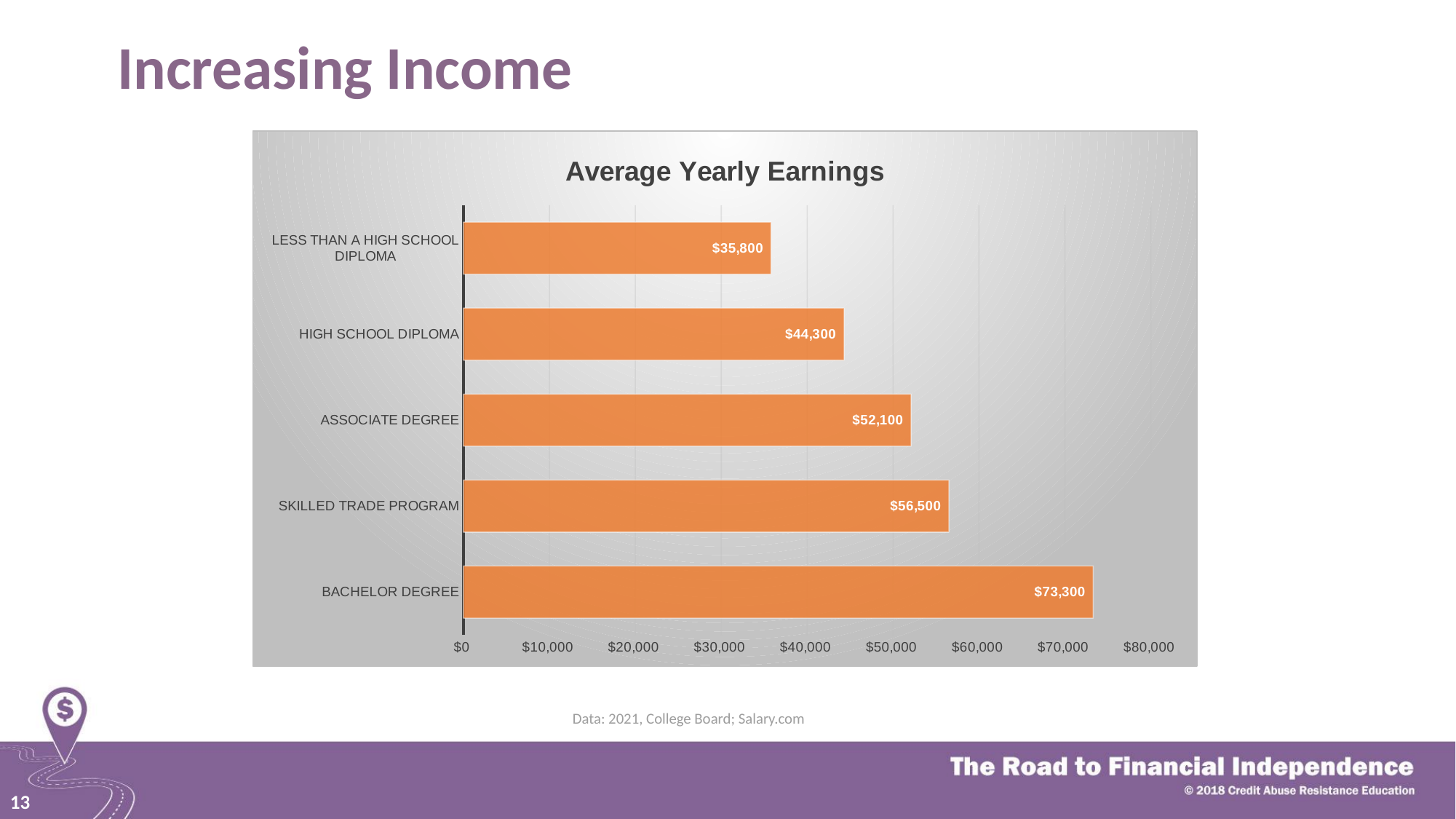
What is the difference in average yearly earnings between a Bachelor Degree and a High School Diploma? $29,000 What is the average yearly earnings for a High School Diploma? $44,300 What is the title of the chart? Average Yearly Earnings Which education level has the lowest average yearly earnings? Less than a High School Diploma Which has higher average yearly earnings: Associate Degree or Skilled Trade Program? Skilled Trade Program Is the average yearly earnings for Less than a High School Diploma greater or less than $40,000? less What type of chart is shown on the slide? bar chart Which education level has the highest average yearly earnings? Bachelor Degree What is the average yearly earnings for a Bachelor Degree? $73,300 What is the average yearly earnings for a Skilled Trade Program? $56,500 What is the difference in average yearly earnings between a Skilled Trade Program and an Associate Degree? $4,400 How many education levels are shown in the chart? 5